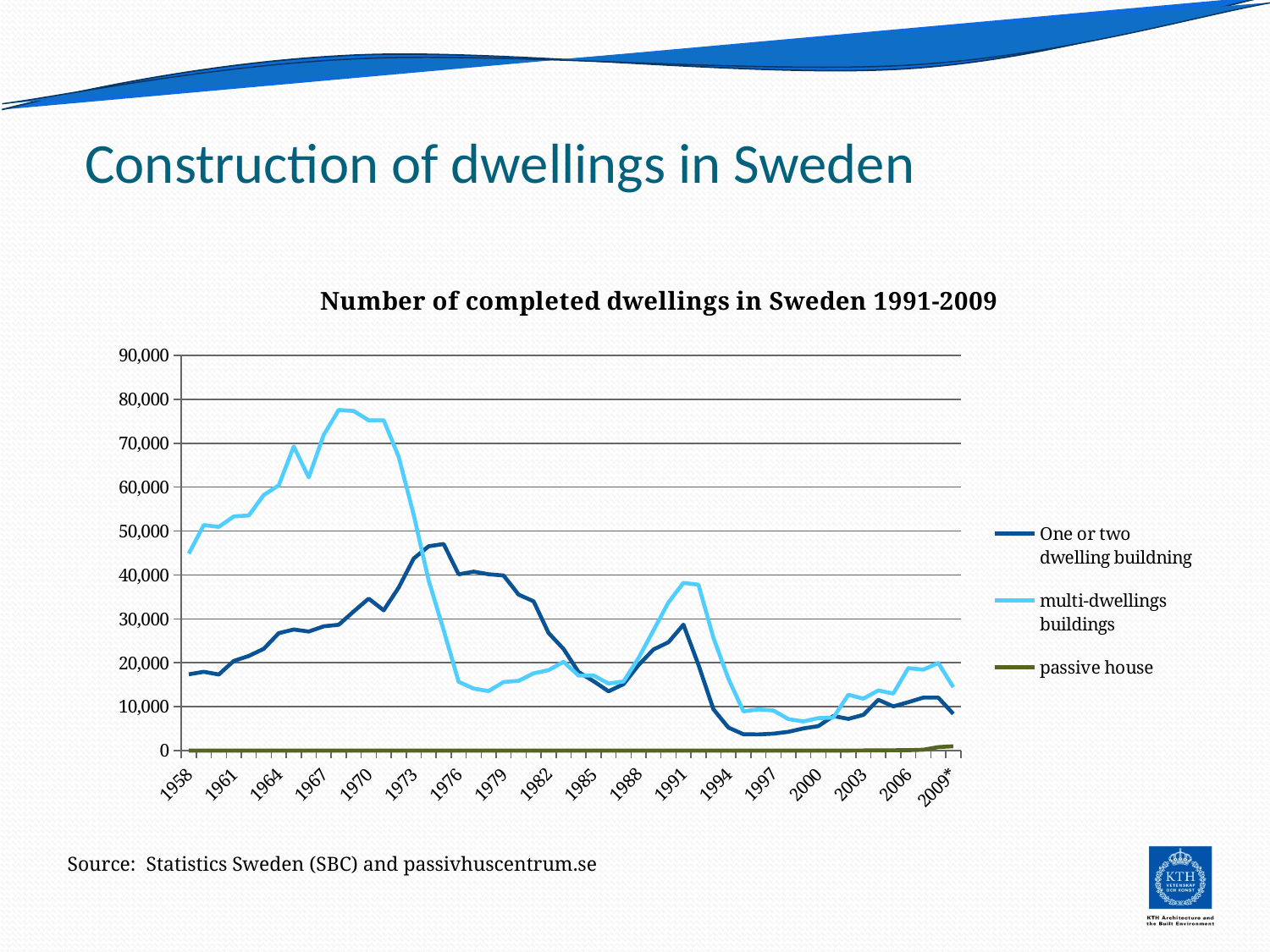
What is the title of the chart? Number of completed dwellings in Sweden 1991-2009 Is the value for One or two dwelling buildning in 1994 greater or less than 10,000? less How many year labels are shown on the x axis? 18 Is the value for One or two dwelling buildning in 1958 greater or less than 10,000? greater What kind of chart is shown on the slide? line chart In 1976, which series has the larger value: One or two dwelling buildning or multi-dwellings buildings? One or two dwelling buildning Does the multi-dwellings buildings series rise or fall between 1970 and 1976? fall How many series does the legend list? 3 Which series is drawn in light blue? multi-dwellings buildings Is the value for multi-dwellings buildings in 1970 greater or less than 70,000? greater Which series reaches the highest value on the chart? multi-dwellings buildings